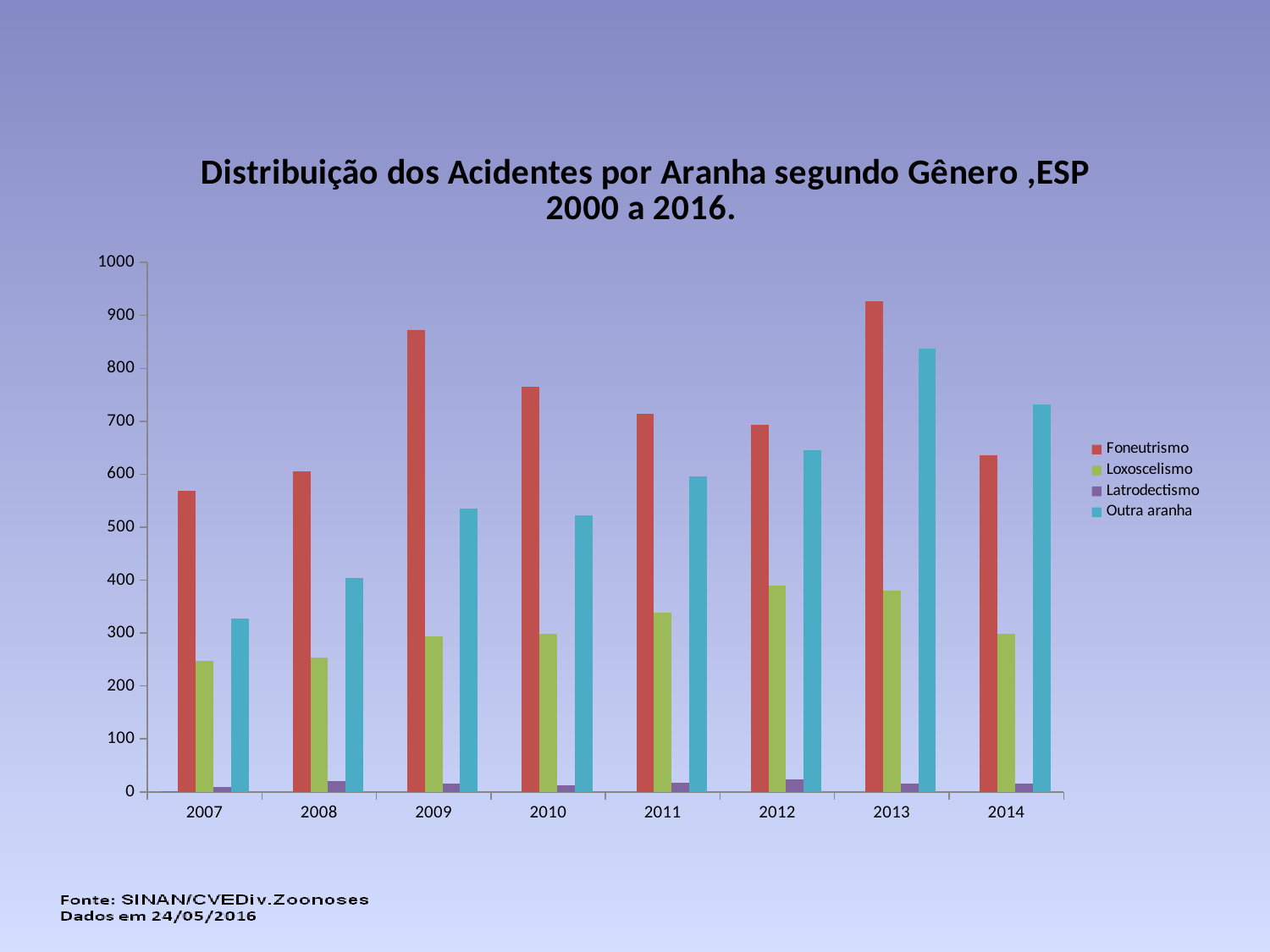
In which year is the Foneutrismo value lowest? 2007 Do the Foneutrismo values rise or fall from 2009 to 2012? fall How many years are shown on the x axis? 8 In which year is the Foneutrismo value highest? 2013 How many series does the legend list? 4 Is the Foneutrismo value for 2009 greater or less than 800? greater Is the Loxoscelismo value for 2012 greater or less than 300? greater In which year is the Outra aranha value lowest? 2007 In 2014, which is larger: Foneutrismo or Outra aranha? Outra aranha What kind of chart is shown on the slide? bar chart Which series has the lowest value in every year? Latrodectismo In which year is the Outra aranha value highest? 2013